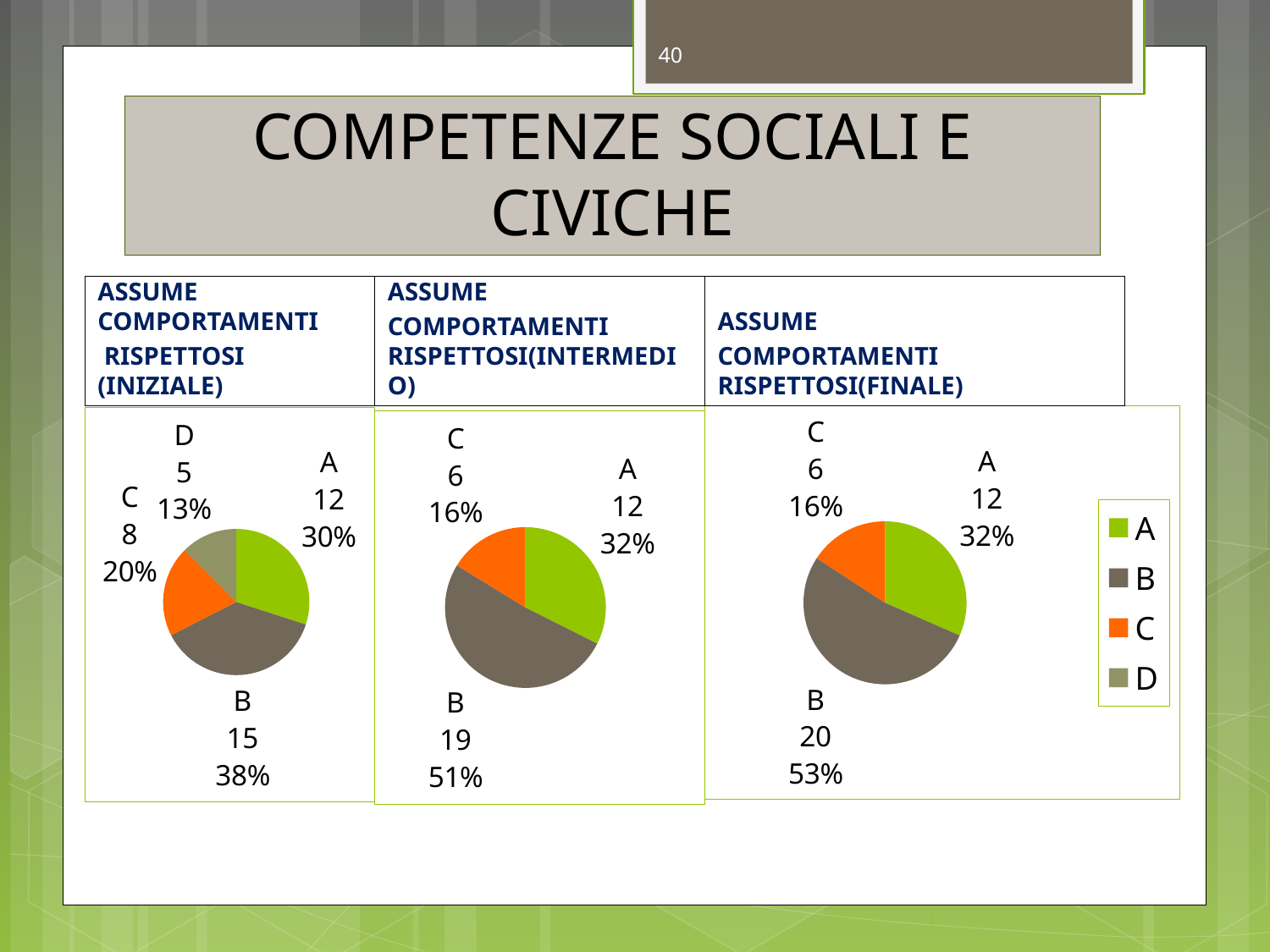
In the INIZIALE pie chart, which category has the smallest value? D In the INTERMEDIO pie chart, what is the value for category B? 19 How many entries does the legend on the right of the slide list? 4 How many categories are shown in the INTERMEDIO pie chart? 3 In the INTERMEDIO pie chart, what share of the pie does category C represent? 16% What kind of chart is used in the INIZIALE panel? Pie chart In the INIZIALE pie chart, what is the difference between the values for B and A? 3 In the FINALE pie chart, which is larger, the value for A or the value for C? A In the FINALE pie chart, what share of the pie does category B represent? 53% In the FINALE pie chart, which category has the largest value? B In the INIZIALE pie chart, what share of the pie does category D represent? 13% In the INIZIALE pie chart, what is the value for category B? 15